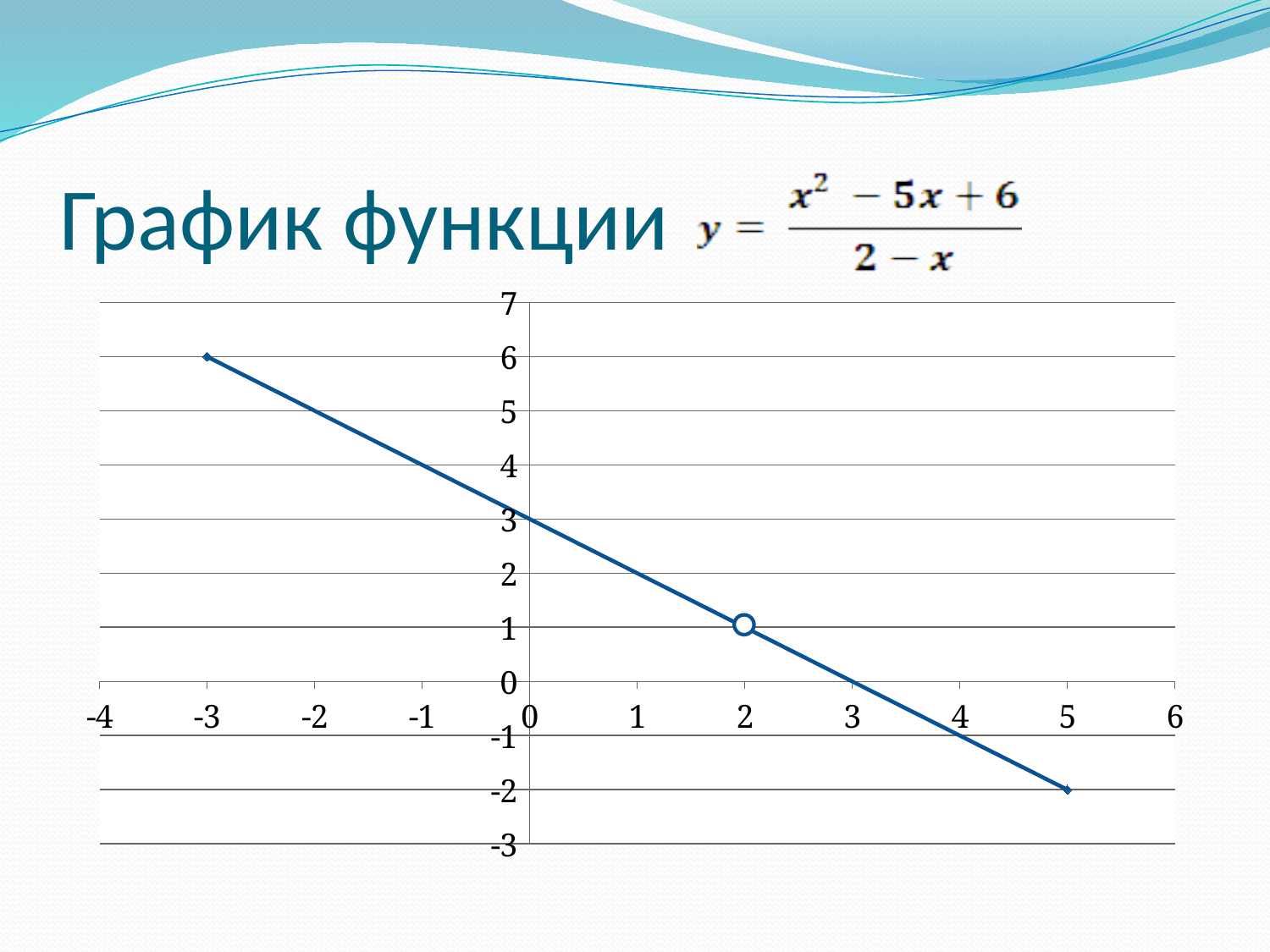
What is the y value of the plotted line at x = 5? -2 Is the y value of the line at x = 1 greater or less than 1? greater Is the y value of the line at x = 4 greater or less than 0? less Do the values of the plotted line rise or fall as x increases? fall At what y value does the plotted line cross the vertical axis (x = 0)? 3 What kind of chart is shown on the slide? line chart At what x value does the plotted line cross the horizontal axis (y = 0)? 3 At which x value is the open circle (excluded point) on the line located? 2 What is the y value of the plotted line at x = -3? 6 What is the lowest y value reached by the plotted line? -2 What is the highest y value reached by the plotted line? 6 Which is larger: the y value of the line at x = -3 or at x = 5? at x = -3